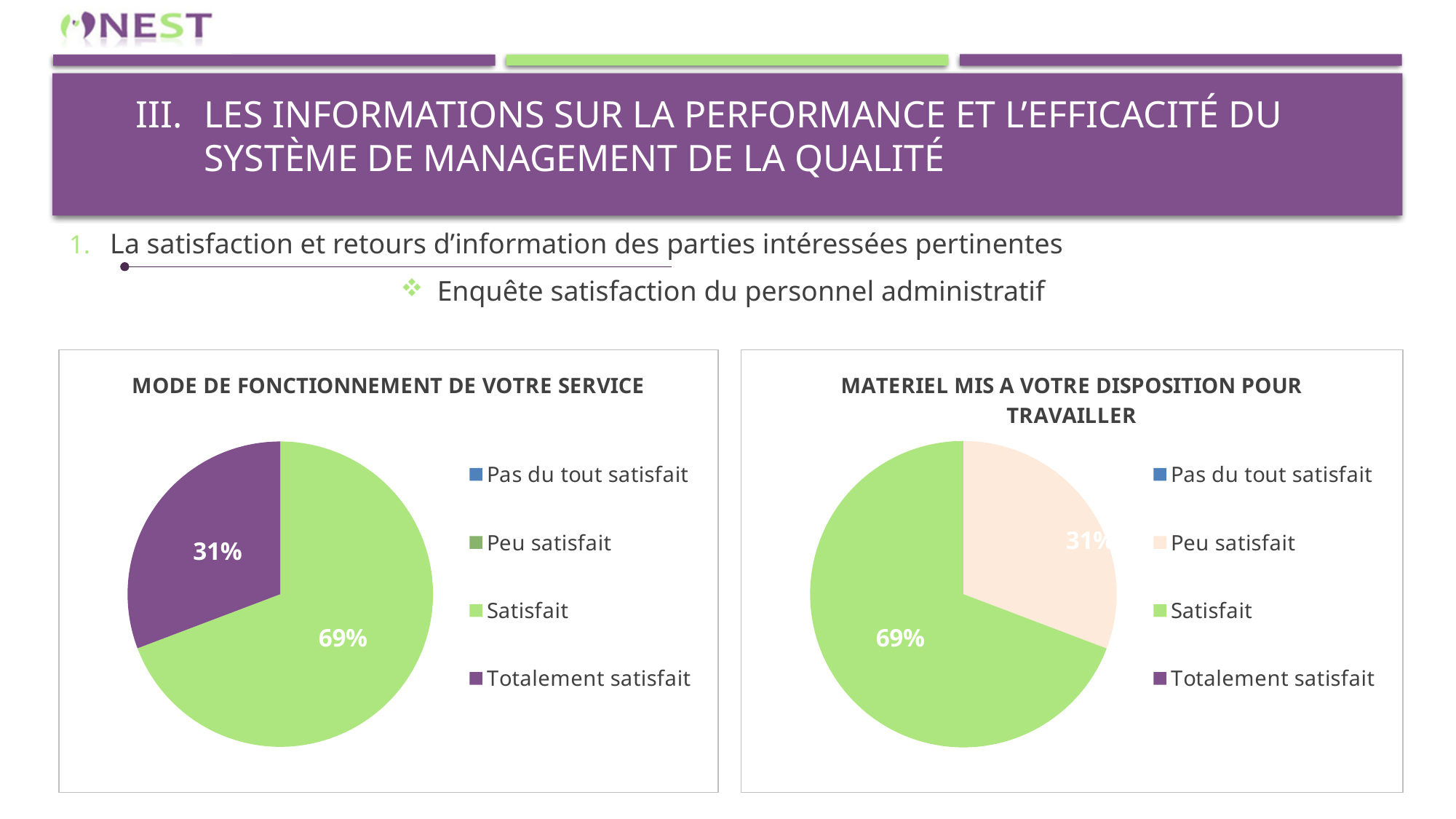
What type of chart is the one on the left of the slide? Pie chart In the chart titled "MODE DE FONCTIONNEMENT DE VOTRE SERVICE", what share of the pie is "Totalement satisfait"? 31% In the chart titled "MATERIEL MIS A VOTRE DISPOSITION POUR TRAVAILLER", which category has the smallest visible slice? Peu satisfait In the chart titled "MODE DE FONCTIONNEMENT DE VOTRE SERVICE", what share of the pie is "Satisfait"? 69% How many entries does the legend of the chart titled "MATERIEL MIS A VOTRE DISPOSITION POUR TRAVAILLER" list? 4 In the chart titled "MODE DE FONCTIONNEMENT DE VOTRE SERVICE", which category has the largest slice? Satisfait In the chart titled "MODE DE FONCTIONNEMENT DE VOTRE SERVICE", what colour is the "Totalement satisfait" slice? Purple In the chart titled "MATERIEL MIS A VOTRE DISPOSITION POUR TRAVAILLER", which is larger, "Satisfait" or "Peu satisfait"? Satisfait How many slices are visible in the pie chart titled "MODE DE FONCTIONNEMENT DE VOTRE SERVICE"? 2 In the chart titled "MODE DE FONCTIONNEMENT DE VOTRE SERVICE", what is the difference in percentage points between "Satisfait" and "Totalement satisfait"? 38 In the chart titled "MATERIEL MIS A VOTRE DISPOSITION POUR TRAVAILLER", what share of the pie is "Satisfait"? 69%